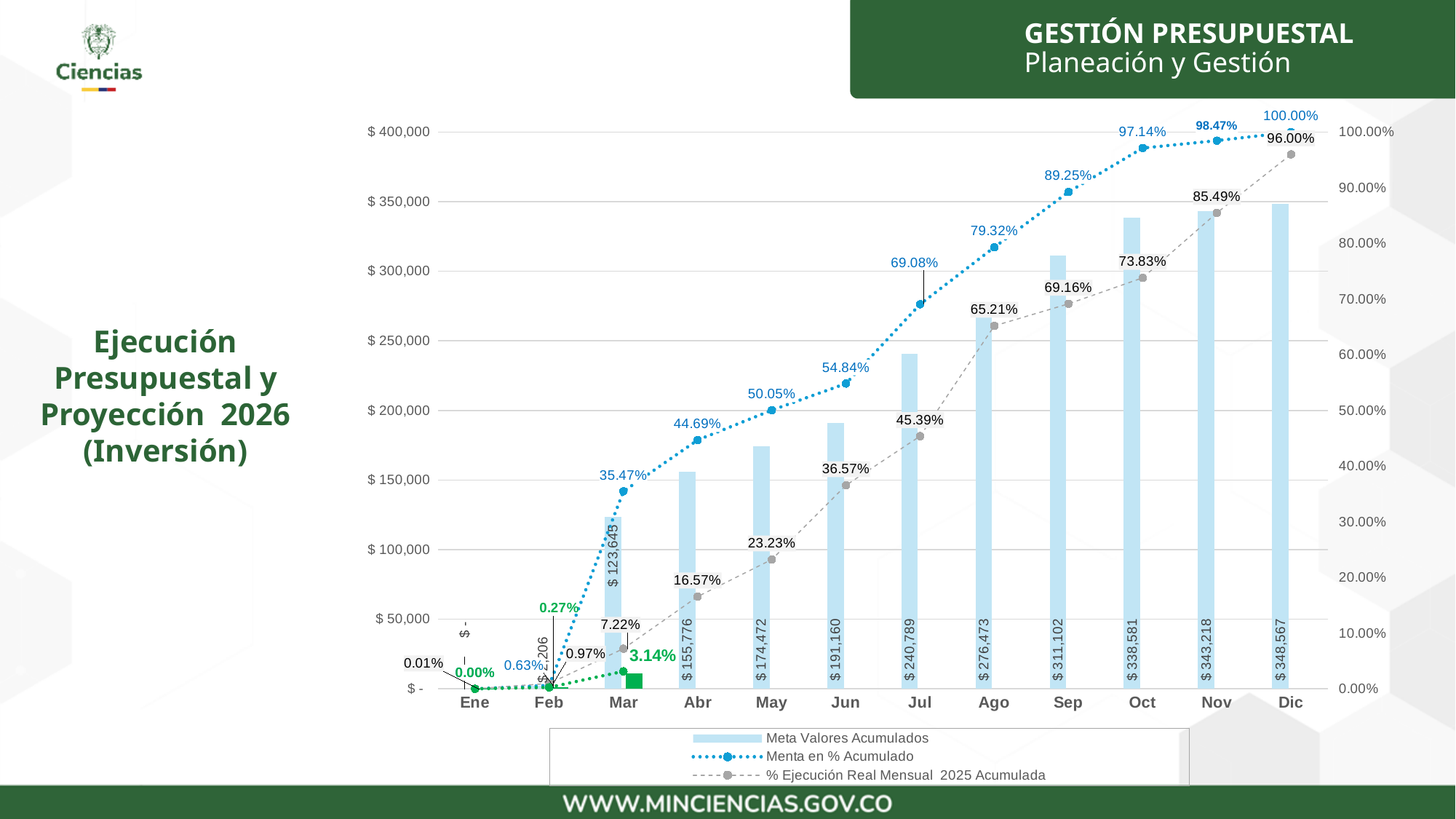
What is the Menta en % Acumulado value for Sep? 89.25% What is the Meta Valores Acumulados value for Dic? $ 348,567 What is the % Ejecución Real Mensual 2025 Acumulada value for Nov? 85.49% What is the difference between the Meta Valores Acumulados for Dic and Nov? $ 5,349 How many series does the legend list? 3 Do the Meta Valores Acumulados bars rise or fall from Ene to Dic? Rise What is the Meta Valores Acumulados value for Jul? $ 240,789 What is the difference between Menta en % Acumulado and % Ejecución Real Mensual 2025 Acumulada in Oct? 23.31% What kind of chart is shown? Combination bar and line chart Which month has the highest Meta Valores Acumulados bar? Dic How many months are shown on the x axis? 12 In Jun, which is larger: Menta en % Acumulado or % Ejecución Real Mensual 2025 Acumulada? Menta en % Acumulado